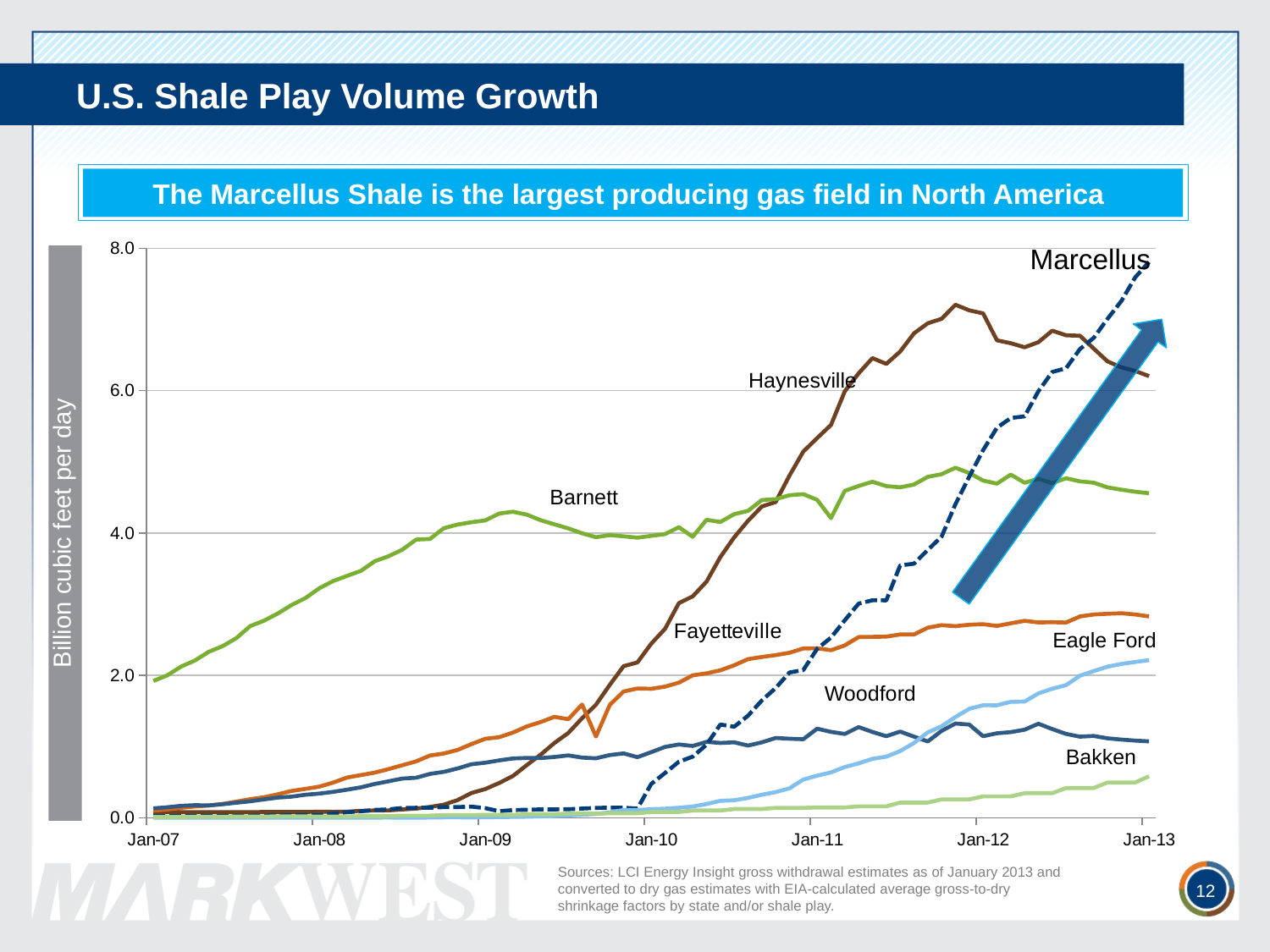
Is the value for Bakken at Jan-13 greater or less than 2.0? less Does the Marcellus line rise or fall from Jan-10 to Jan-13? Rises At Jan-13, which is larger: Barnett or Fayetteville? Barnett Is the value for Marcellus at Jan-13 greater or less than 6.0? greater How many shale plays (series) are plotted on the chart? 7 Which shale play has the highest value at Jan-09? Barnett What is the label on the vertical axis of the chart? Billion cubic feet per day Which shale play has the highest value at Jan-13? Marcellus Is the value for Barnett at Jan-13 greater or less than 4.0? greater Which shale play has the lowest value at Jan-13? Bakken What kind of chart is shown on the slide? Line chart At Jan-13, which is larger: Marcellus or Haynesville? Marcellus